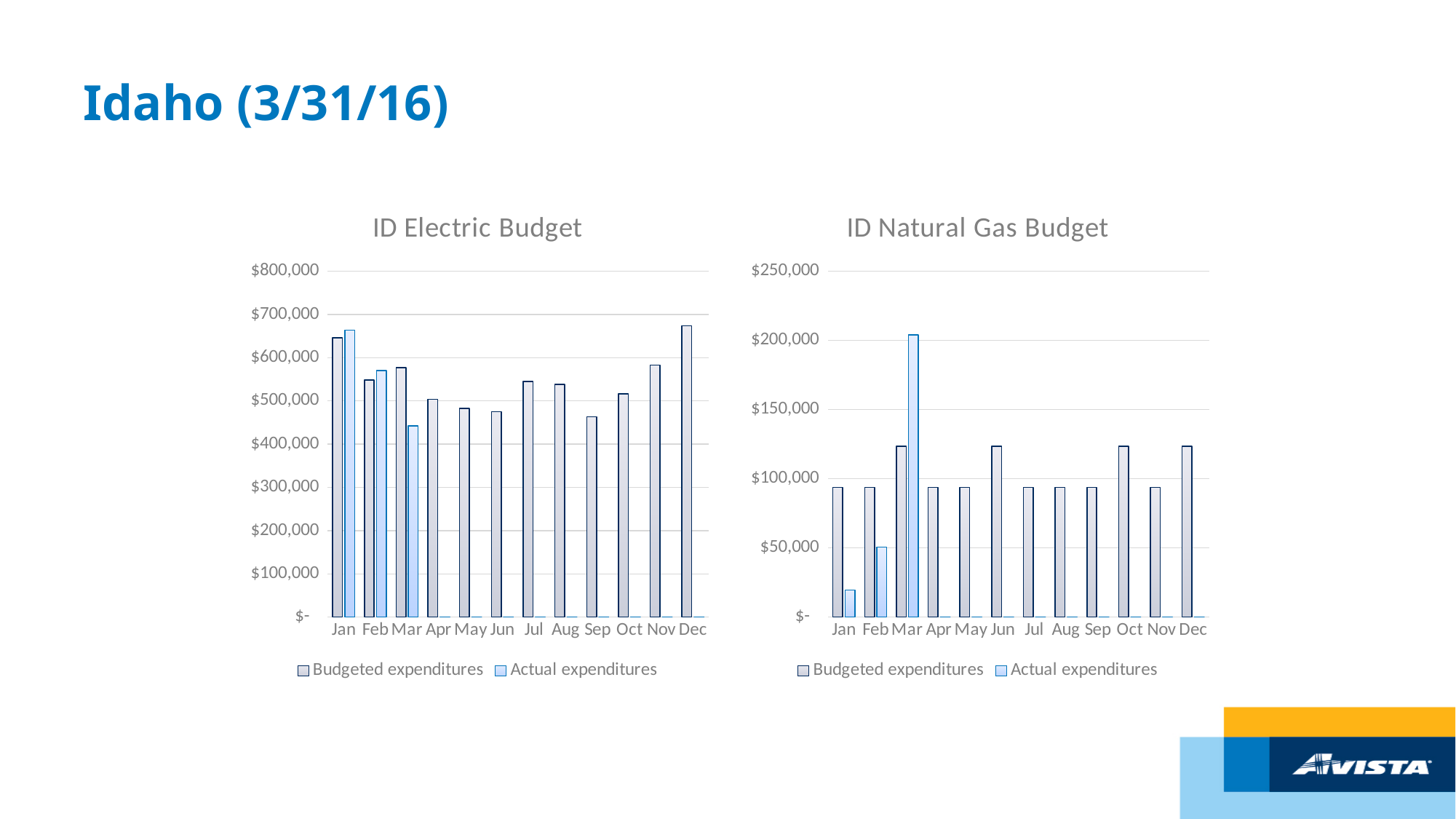
On the ID Electric Budget chart, which is larger for Mar: budgeted expenditures or actual expenditures? Budgeted expenditures On the ID Electric Budget chart, what kind of chart is shown? Bar chart On the ID Natural Gas Budget chart, which is larger for Mar: budgeted expenditures or actual expenditures? Actual expenditures On the ID Natural Gas Budget chart, how many months have an actual expenditures bar? 3 On the ID Electric Budget chart, is the actual expenditures value for Mar greater or less than $500,000? less On the ID Natural Gas Budget chart, is the actual expenditures value for Mar greater or less than $150,000? greater On the ID Electric Budget chart, which month has the highest budgeted expenditures? Dec On the ID Electric Budget chart, is the budgeted expenditures value for Jan greater or less than $600,000? greater On the ID Electric Budget chart, how many series does the legend list? 2 On the ID Electric Budget chart, how many months are shown on the x axis? 12 On the ID Natural Gas Budget chart, which month has the highest actual expenditures? Mar